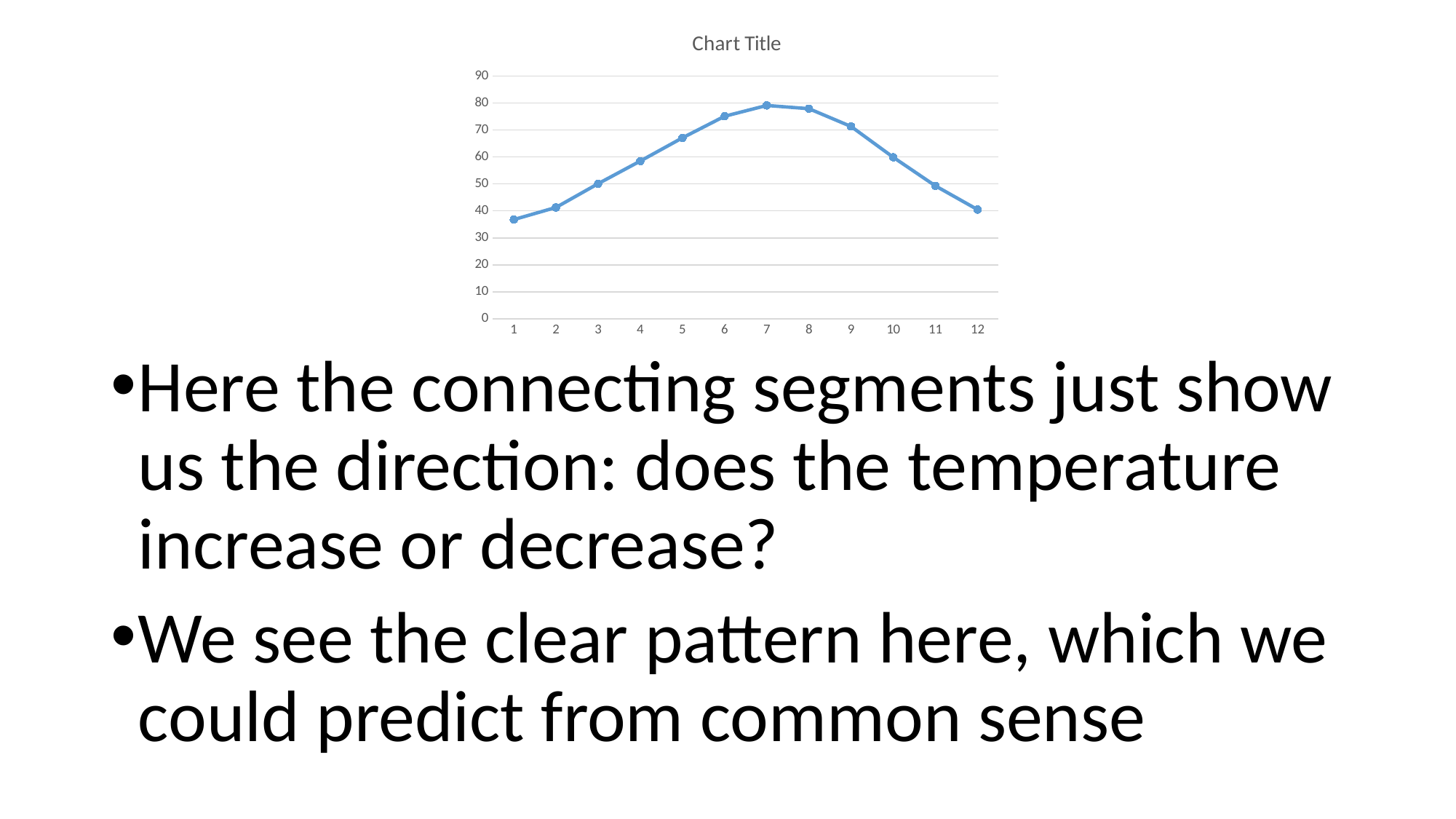
How many data points are plotted on the line? 12 Which has the larger value, category 2 or category 9? 9 At which x-axis category does the line reach its lowest value? 1 Is the value at category 5 greater or less than 60? greater Is the value at category 1 greater or less than 40? less Is the value at category 12 greater or less than 50? less Which has the larger value, category 4 or category 11? 4 At which x-axis category does the line reach its highest value? 7 What is the title of the chart? Chart Title What kind of chart is shown on the slide? line chart Do the values rise or fall from category 7 to category 12? fall